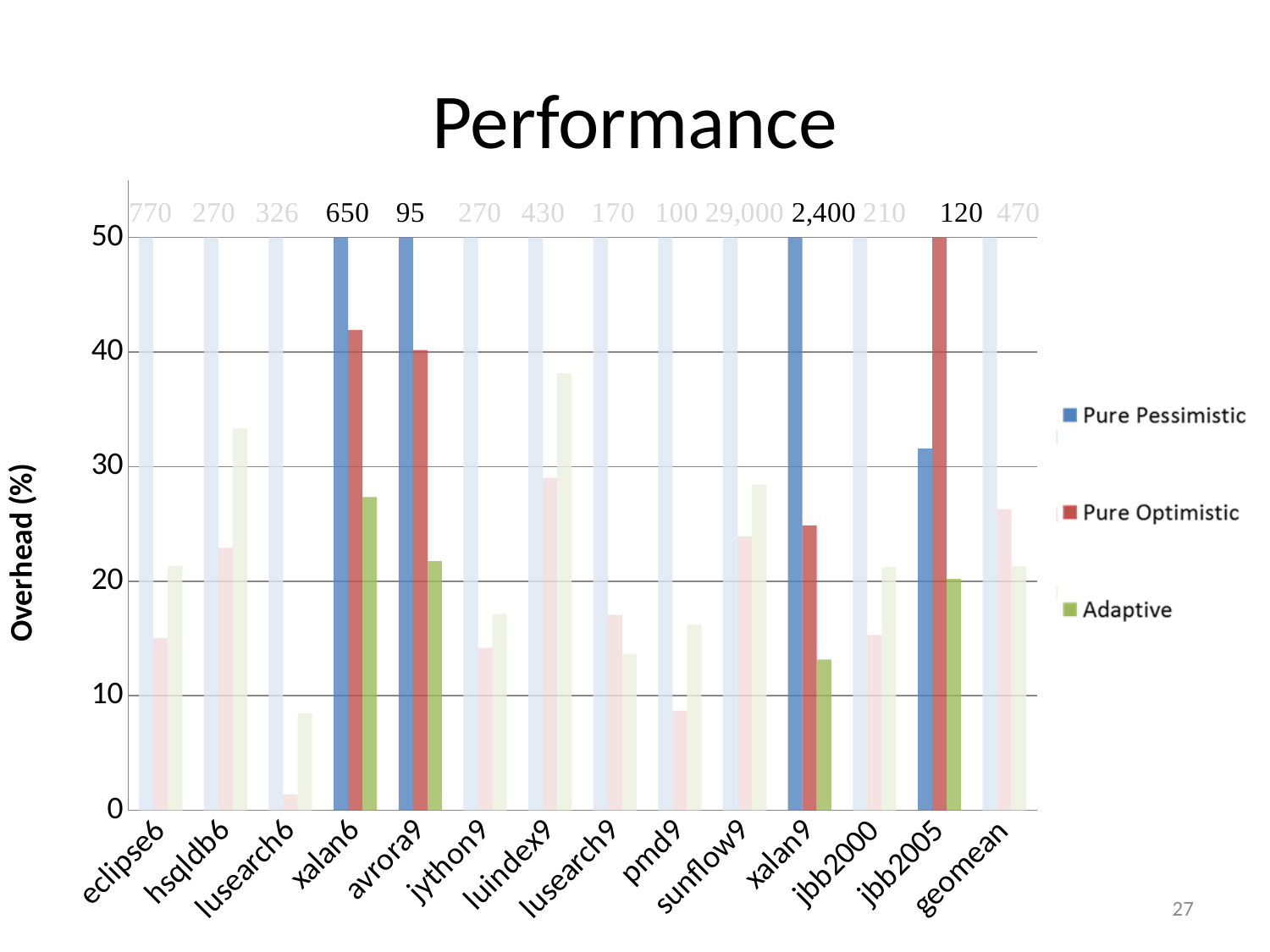
Is the Pure Pessimistic value for jbb2005 greater or less than 40? less What number is printed above the bars for xalan9? 2,400 Which series is shown in green in the legend? Adaptive For xalan9, which is larger: the Pure Optimistic value or the Adaptive value? Pure Optimistic Is the Adaptive value for xalan6 greater or less than 20? greater How many series does the legend list? 3 What number is printed above the bars for xalan6? 650 What number is printed above the bars for sunflow9? 29,000 What is the label of the y axis? Overhead (%) Is the Adaptive value for xalan9 greater or less than 20? less What kind of chart is shown on the slide? bar chart How many benchmark categories are shown along the x axis? 14